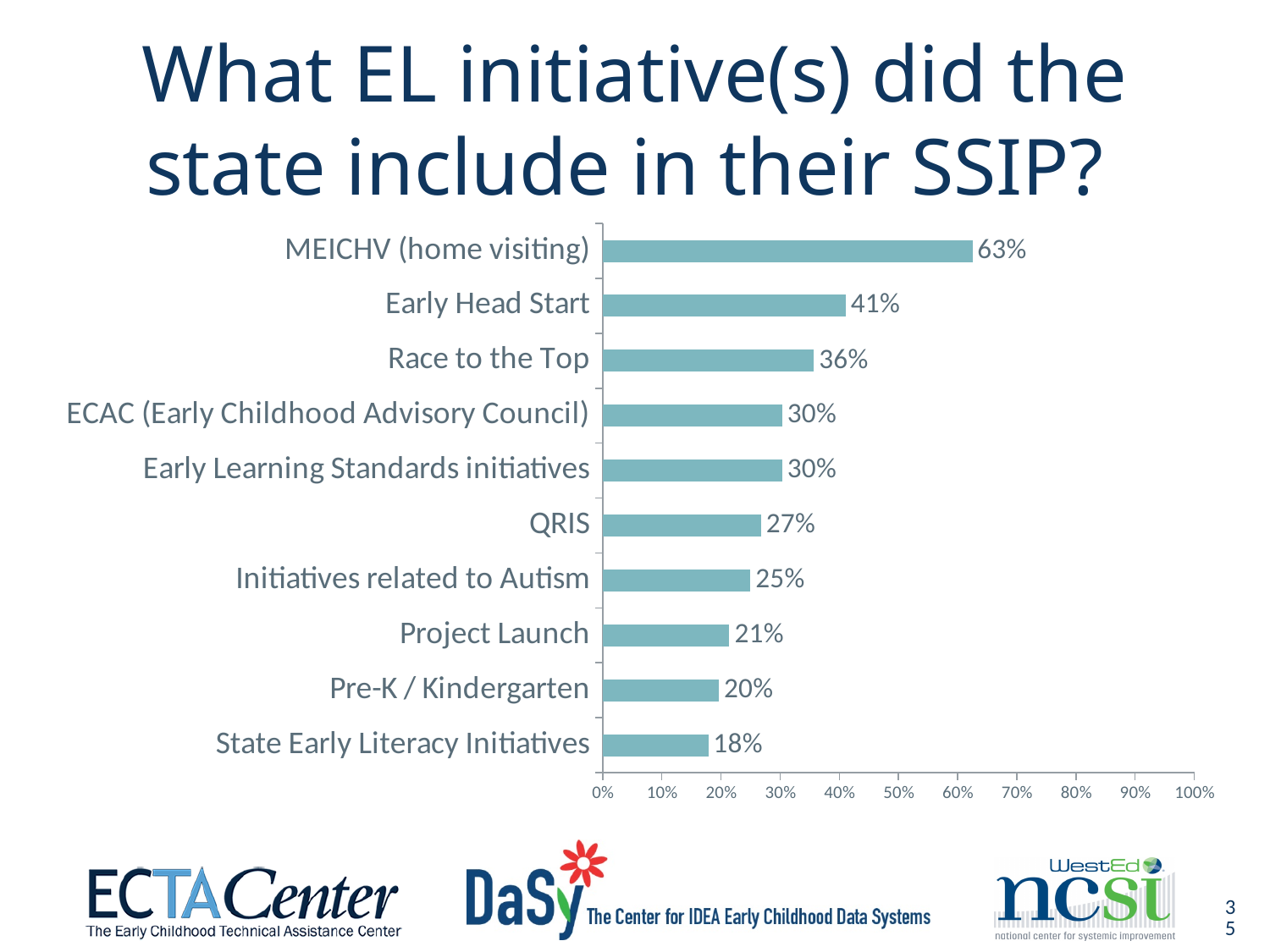
Which EL initiative has the lowest percentage? State Early Literacy Initiatives Which is larger, the value for Race to the Top or the value for Project Launch? Race to the Top What kind of chart is shown on the slide? bar chart Is the value for Initiatives related to Autism greater or less than 30%? less Which EL initiative has the highest percentage? MEICHV (home visiting) What percentage of states included MEICHV (home visiting) in their SSIP? 63% What is the maximum value shown on the horizontal axis? 100% What is the value shown for Early Head Start? 41% How many EL initiatives are shown in the chart? 10 What is the value shown for QRIS? 27% What is the difference between the values for MEICHV (home visiting) and Early Head Start? 22% What is the value shown for State Early Literacy Initiatives? 18%